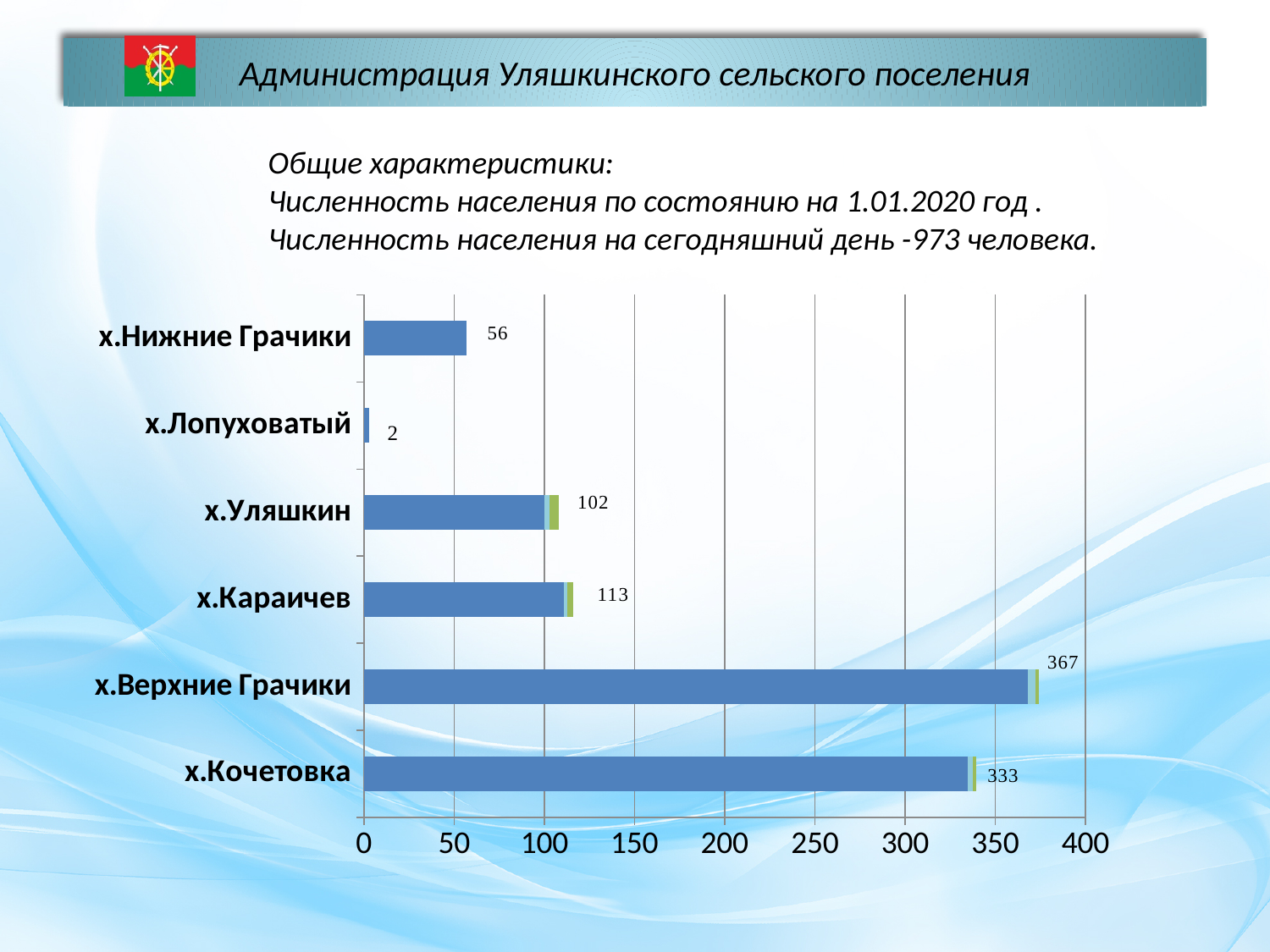
What is the value shown for х.Лопуховатый? 2 What is the difference between the values for х.Караичев and х.Уляшкин? 11 What is the value shown for х.Уляшкин? 102 What is the value shown for х.Верхние Грачики? 367 Is the value for х.Кочетовка greater or less than 300? greater What is the value shown for х.Кочетовка? 333 Which category has the lowest value? х.Лопуховатый Which is larger, the value for х.Нижние Грачики or the value for х.Уляшкин? х.Уляшкин What is the difference between the values for х.Верхние Грачики and х.Кочетовка? 34 What kind of chart is shown on the slide? bar chart How many categories are shown on the chart? 6 Which category has the highest value? х.Верхние Грачики